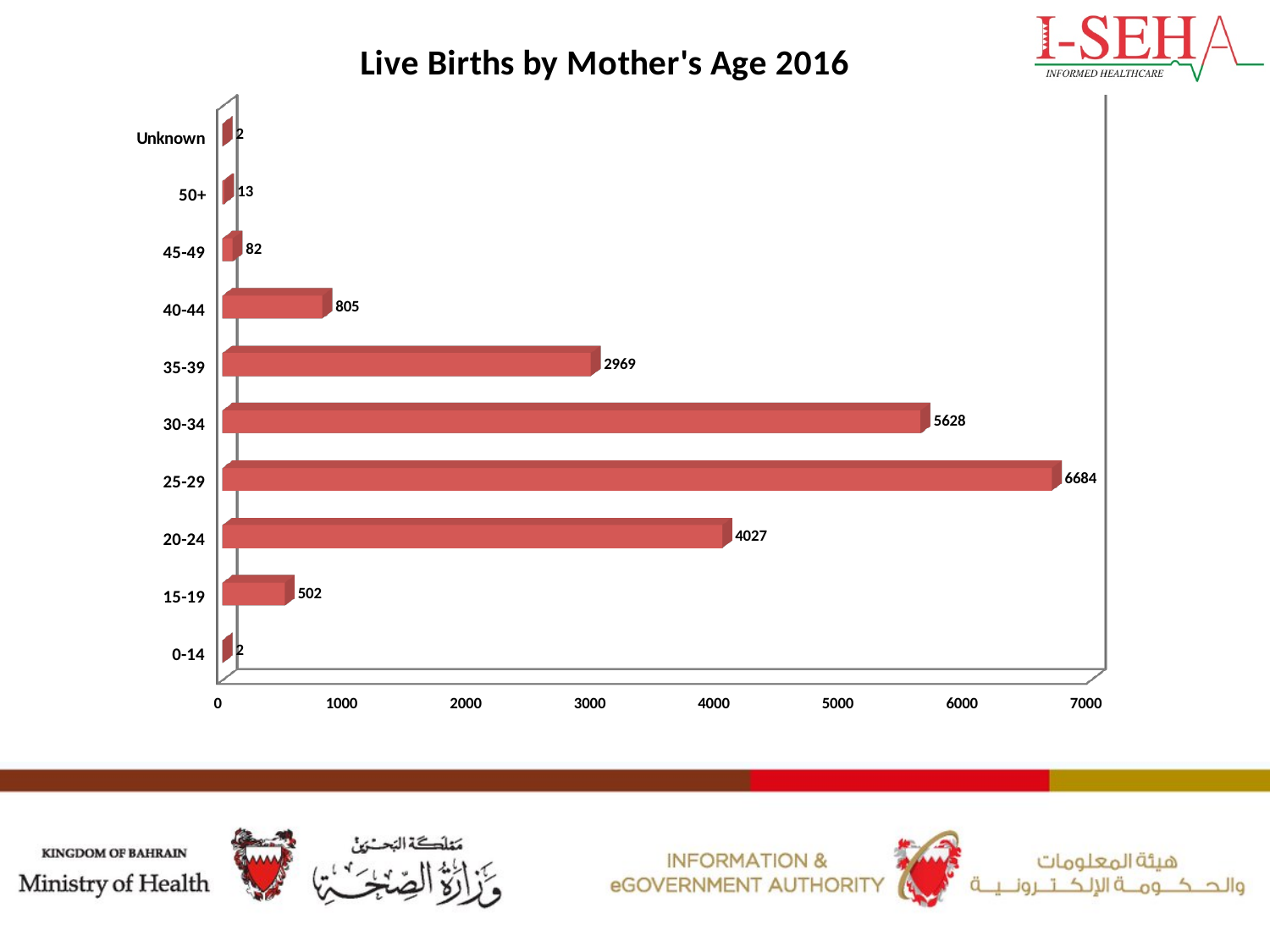
Which mother's age group has the highest number of live births? 25-29 What kind of chart is shown on the slide? Bar chart What is the difference in live births between the 25-29 and 30-34 age groups? 1056 What is the number of live births for mothers aged 40-44? 805 What is the number of live births for mothers aged 50+? 13 Which age group has more live births, 15-19 or 40-44? 40-44 How many age categories are shown on the chart? 10 What is the title of the chart? Live Births by Mother's Age 2016 Which age group has more live births, 20-24 or 35-39? 20-24 What is the number of live births for mothers aged 25-29? 6684 What is the difference in live births between the 20-24 and 35-39 age groups? 1058 Is the value for the 30-34 age group greater or less than 5000? greater